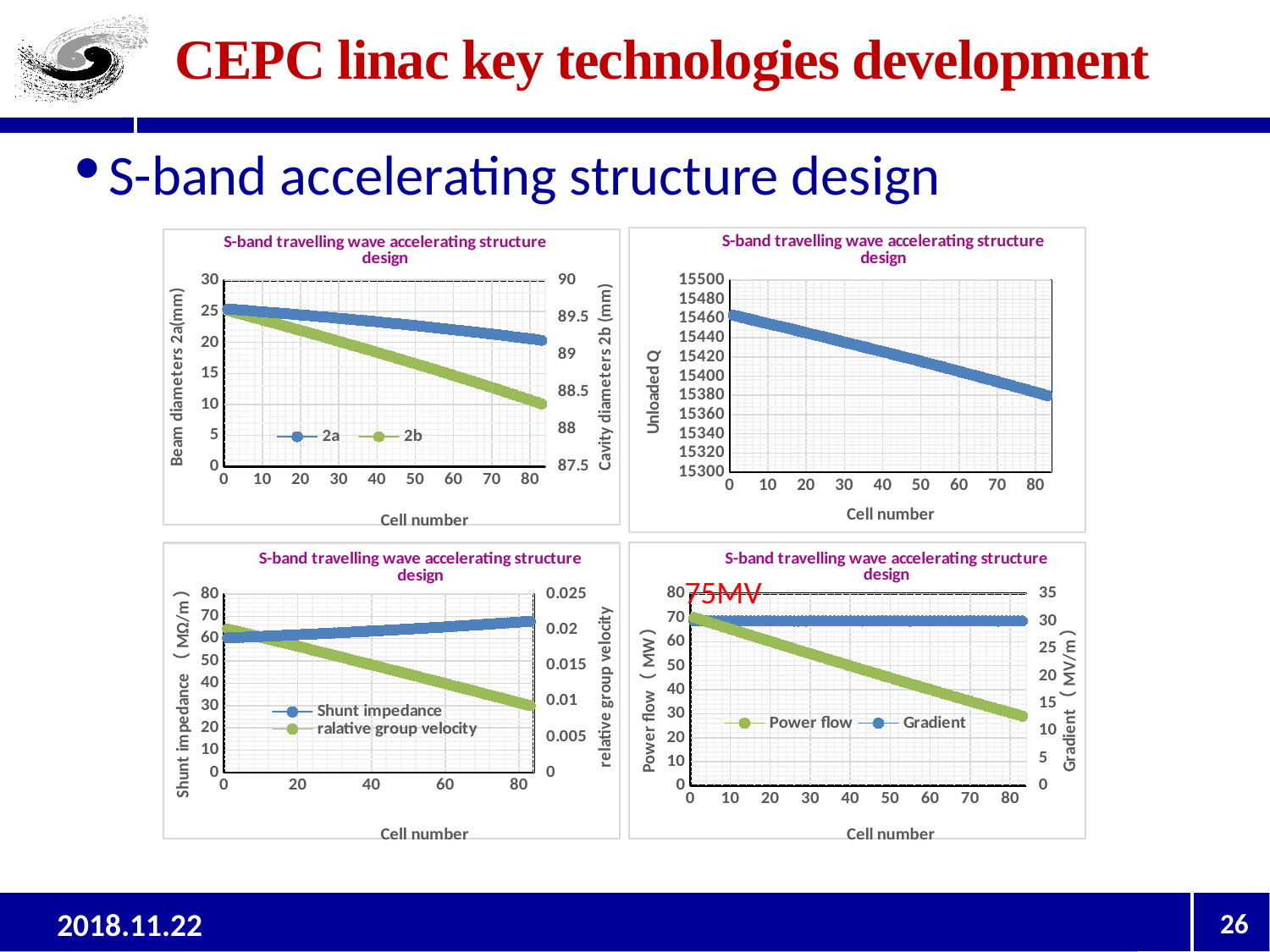
In the bottom-right chart, is the Power flow at cell number 0 greater or less than 60 MW? greater In the bottom-right chart, how many series does the legend list? 2 In the bottom-left chart, does the relative group velocity rise or fall as the cell number increases? fall In the bottom-left chart, does the Shunt impedance rise or fall as the cell number increases? rise In the bottom-right chart, is the Power flow at cell number 80 greater or less than 40 MW? less In the top-right chart, is the Unloaded Q at cell number 80 greater or less than 15400? less In the top-left chart, how many series does the legend list? 2 In the top-left chart, does the 2a series rise or fall as the cell number increases? fall What kind of chart is the top-right chart? line chart